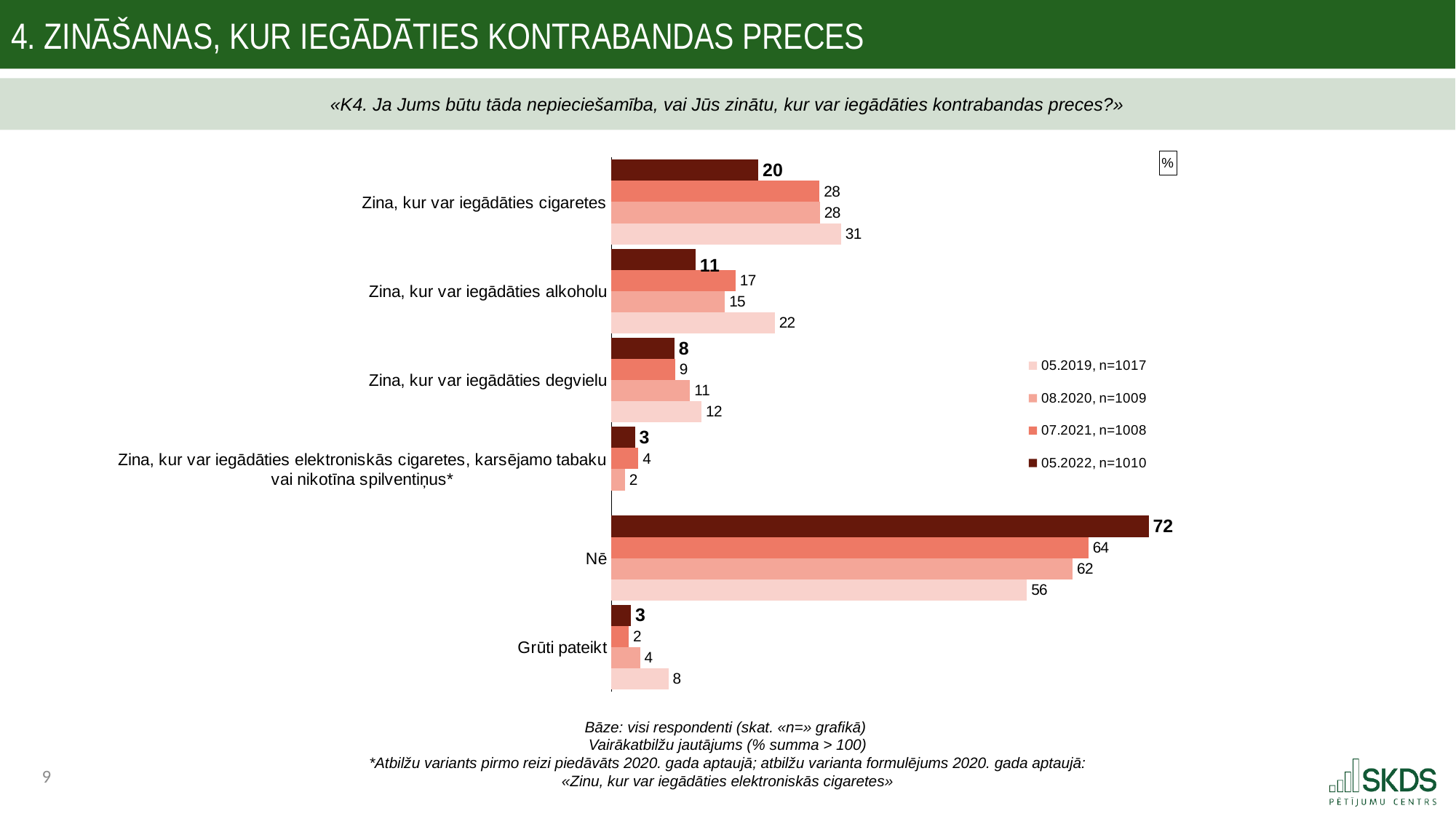
What is the value for "Grūti pateikt" in the 07.2021, n=1008 series? 2 Which category has the highest value in the 05.2022, n=1010 series? Nē What is the difference between the 05.2022 and 05.2019 values for "Nē"? 16 What kind of chart is shown on the slide? Bar chart What is the value for "Zina, kur var iegādāties alkoholu" in the 08.2020, n=1009 series? 15 What is the value for "Nē" in the 05.2022, n=1010 series? 72 Which series is shown with the darkest colour in the legend? 05.2022, n=1010 How many categories are shown on the chart? 6 What is the value for "Zina, kur var iegādāties cigaretes" in the 05.2019, n=1017 series? 31 How many series does the legend list? 4 Which category has the lowest value in the 05.2019, n=1017 series? Grūti pateikt For "Zina, kur var iegādāties cigaretes", which is larger: the 05.2019 value or the 05.2022 value? 05.2019